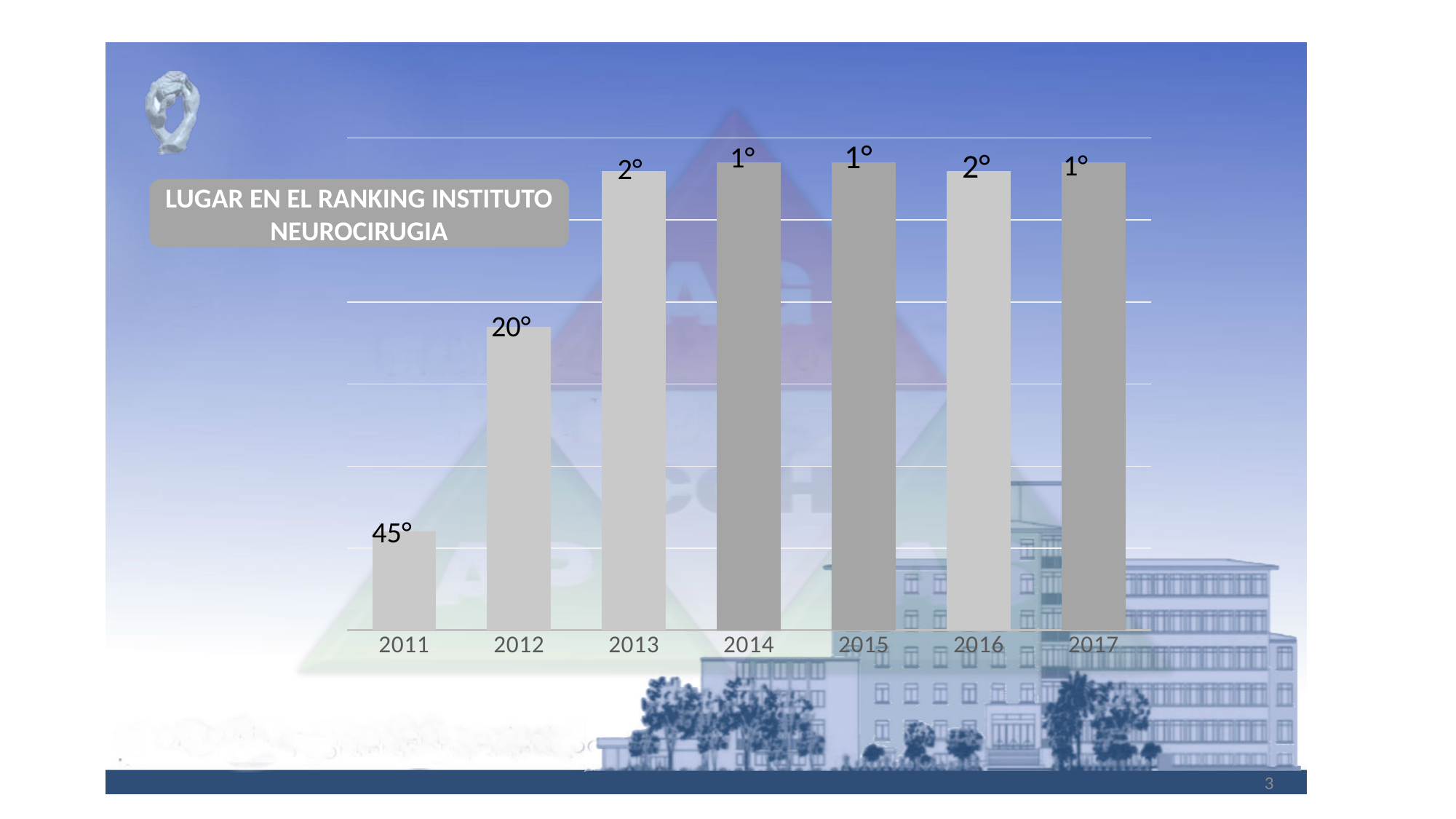
What ranking position is shown for 2017? 1° What kind of chart is shown on the slide? Bar chart What ranking position is shown for 2013? 2° What ranking position is shown for 2016? 2° What is the title of the chart? LUGAR EN EL RANKING INSTITUTO NEUROCIRUGIA What ranking position is shown for 2011? 45° How many years are shown on the x axis? 7 Which ranking number is larger, the one for 2011 or the one for 2012? 2011 Which year has the largest ranking number (worst position)? 2011 By how many positions does the ranking number for 2011 exceed that for 2012? 25 What ranking position is shown for 2012? 20° Which year has the shortest bar? 2011